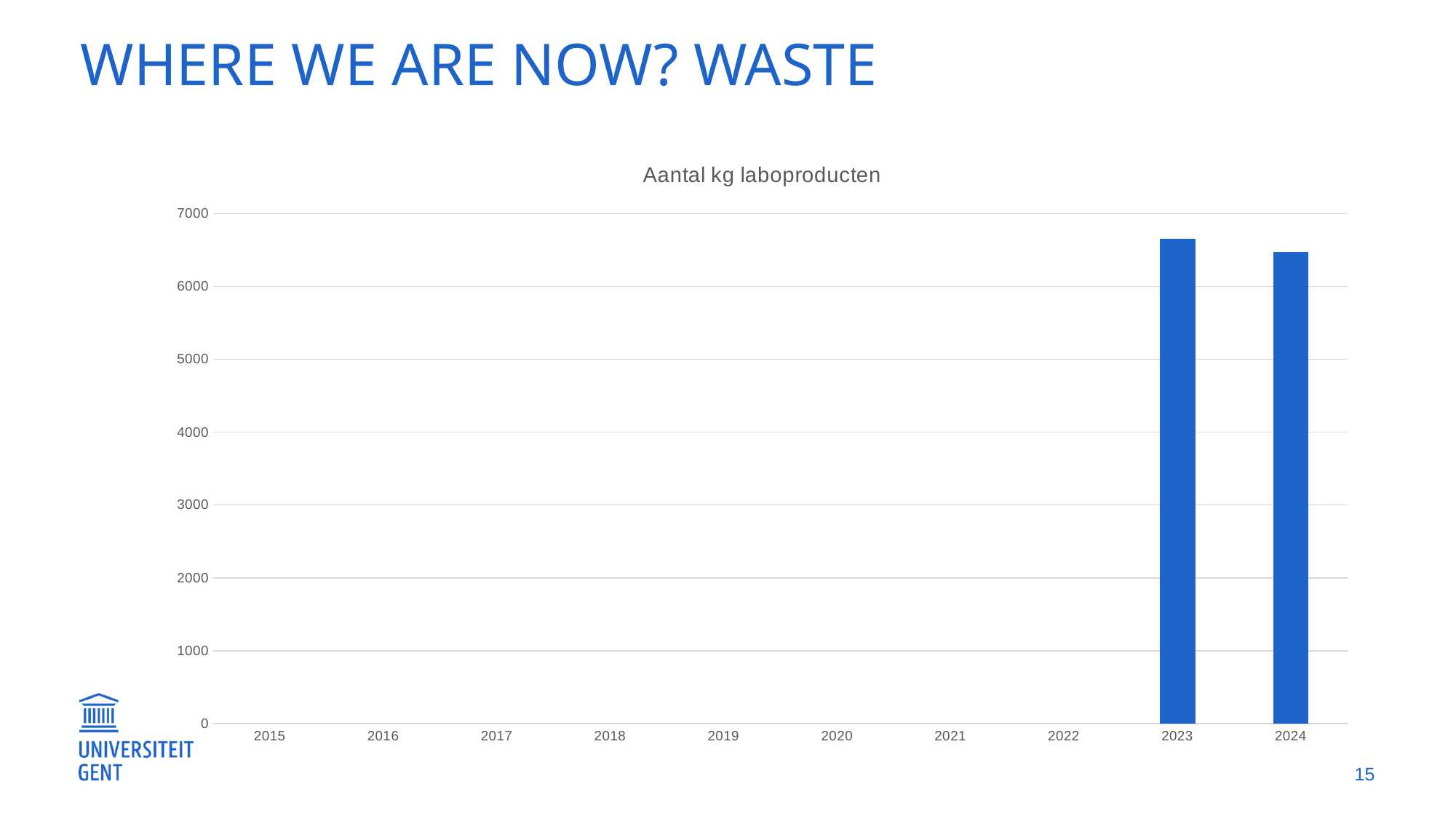
Which years have a bar plotted in the chart? 2023 and 2024 Is the value for 2024 greater or less than 6000? greater Is the value for 2023 greater or less than 6000? greater Is the value for 2024 greater or less than 7000? less How many years are labelled on the x axis of the chart? 10 Which is larger, the value for 2023 or the value for 2024? 2023 What kind of chart is shown on the slide? bar chart Does the value rise or fall from 2023 to 2024? fall How many years in the chart actually have a bar plotted? 2 Which year has the highest value in the chart? 2023 What is the title of the chart? Aantal kg laboproducten